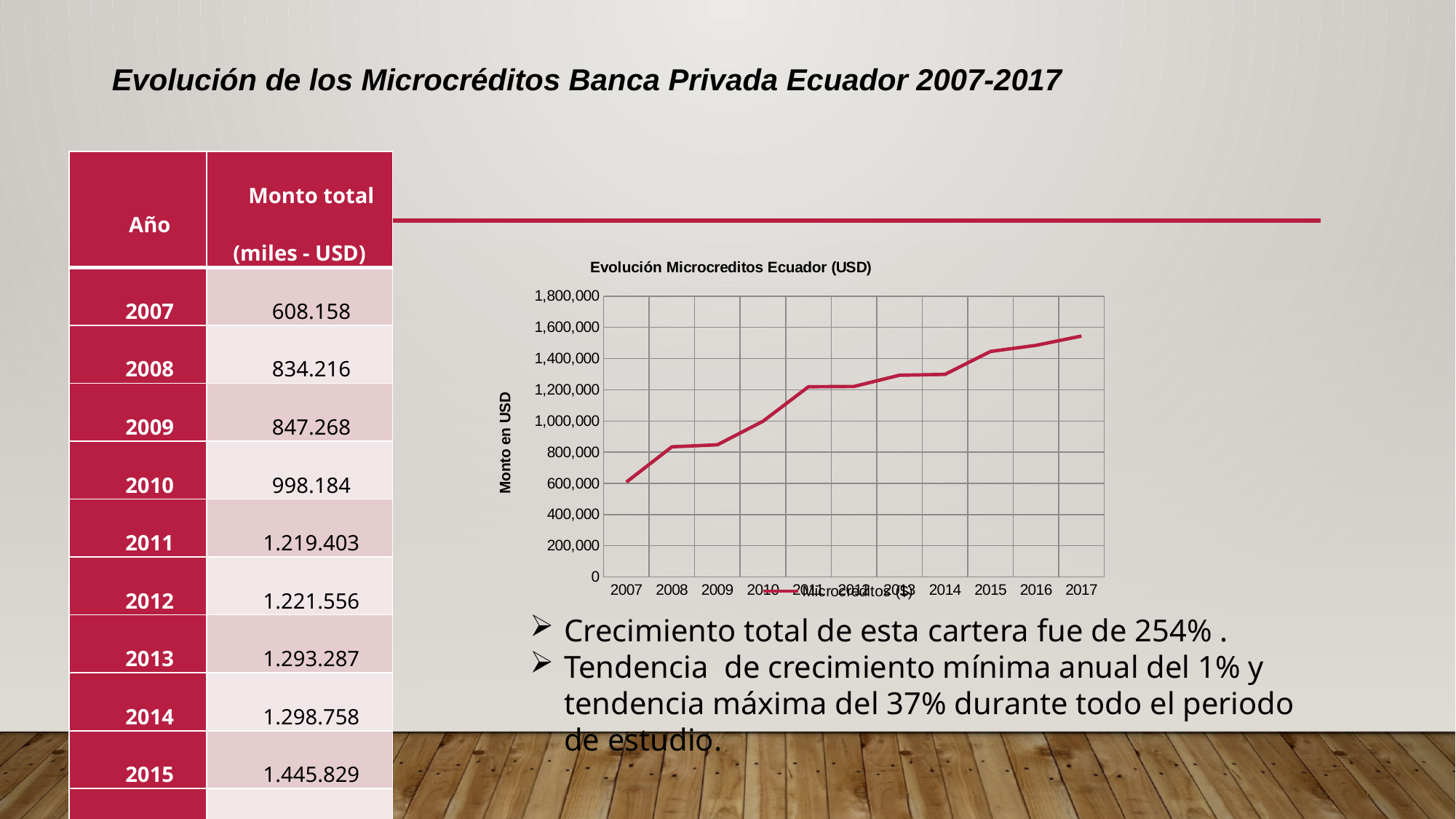
Is the value for 2017 greater or less than 1,400,000? greater What type of chart is shown on the slide? line chart Do the values in the chart rise or fall from 2007 to 2017? rise How many years are plotted along the x axis of the chart? 11 Which year has the lowest value in the chart? 2007 Which year has the highest value in the chart? 2017 What is the title of the chart? Evolución Microcreditos Ecuador (USD) Is the value for 2007 greater or less than 800,000? less How many series does the chart's legend list? 1 Is the value for 2011 greater or less than 1,000,000? greater What is the label on the vertical axis of the chart? Monto en USD Which year has the larger value, 2009 or 2014? 2014